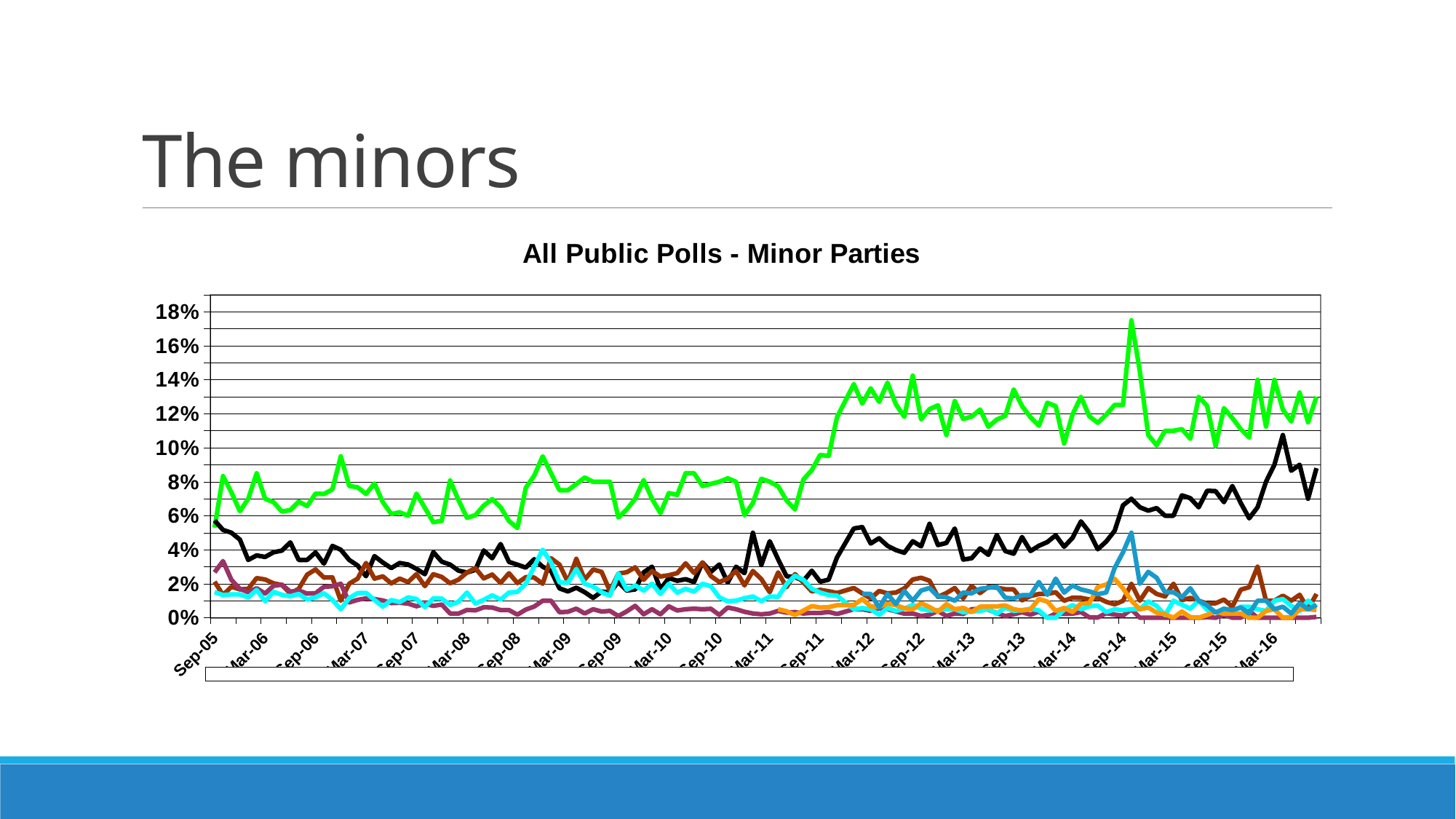
Which coloured line reaches the highest value anywhere on the chart? The green line Is the value of the purple line at Mar-16 greater or less than 2%? less What is the highest value shown on the vertical axis of the chart? 18% At Mar-12, which is higher, the green line or the black line? The green line How many date labels are shown along the x axis of the chart? 22 Is the value of the green line at Sep-05 greater or less than 4%? greater What is the title of the chart? All Public Polls - Minor Parties Is the value of the black line at Mar-08 greater or less than 6%? less What kind of chart is shown on the slide? Line chart Does the green line overall rise or fall between Sep-05 and Mar-16? Rise Does the black line overall rise or fall between Mar-11 and Mar-16? Rise